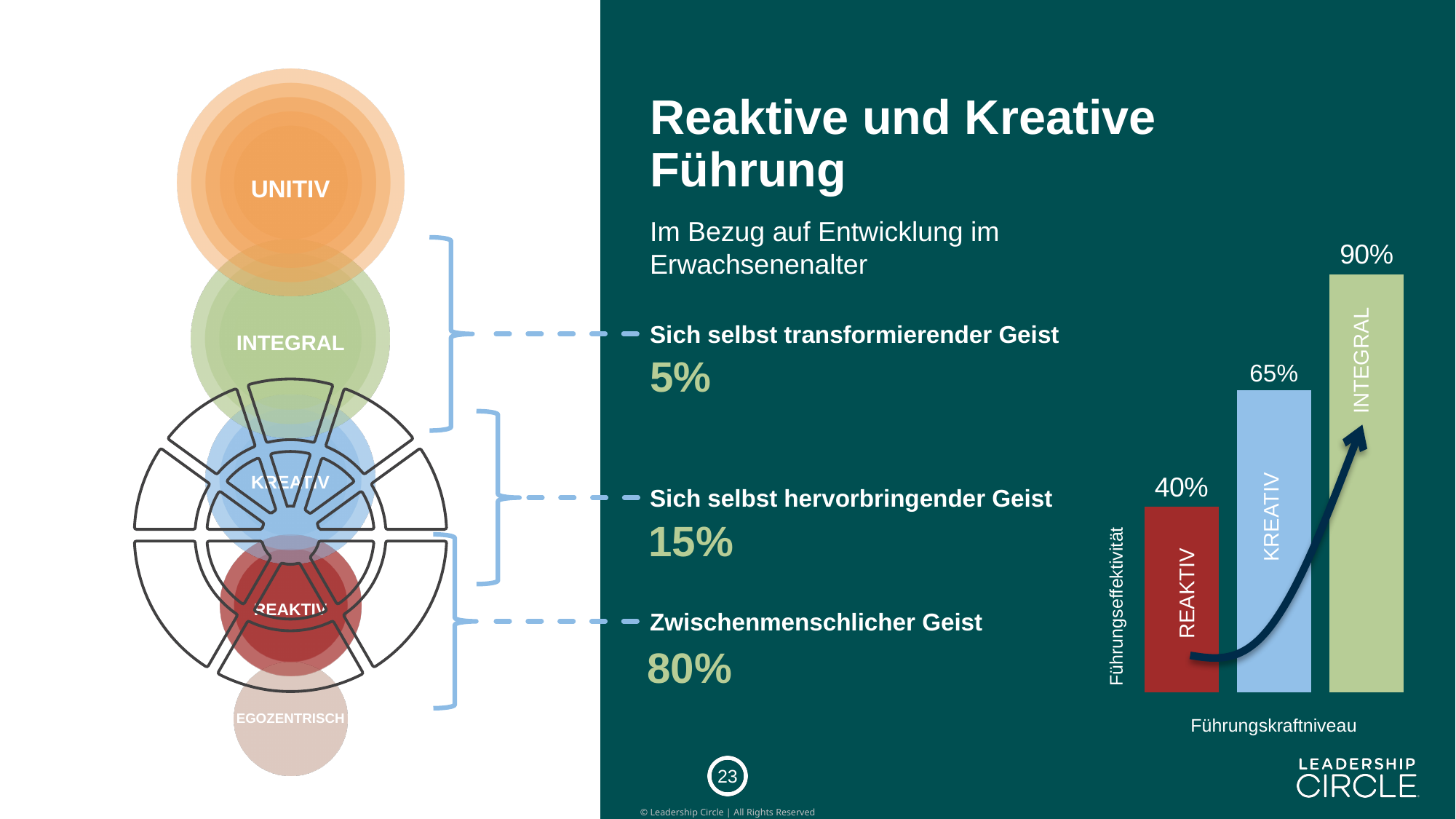
What is the difference between the INTEGRAL and REAKTIV values in the bar chart? 50% What is the value shown for the REAKTIV bar in the bar chart? 40% What is the value shown for the KREATIV bar in the bar chart? 65% What is the difference between the KREATIV and REAKTIV values in the bar chart? 25% What kind of chart is shown on the right side of the slide? bar chart Which is larger in the bar chart, the KREATIV value or the REAKTIV value? KREATIV What is the value shown for the INTEGRAL bar in the bar chart? 90% Do the values in the bar chart rise or fall from left to right? rise How many bars are shown in the bar chart? 3 Which bar in the chart has the highest value? INTEGRAL What is the label on the horizontal axis of the bar chart? Führungskraftniveau Which bar in the chart has the lowest value? REAKTIV